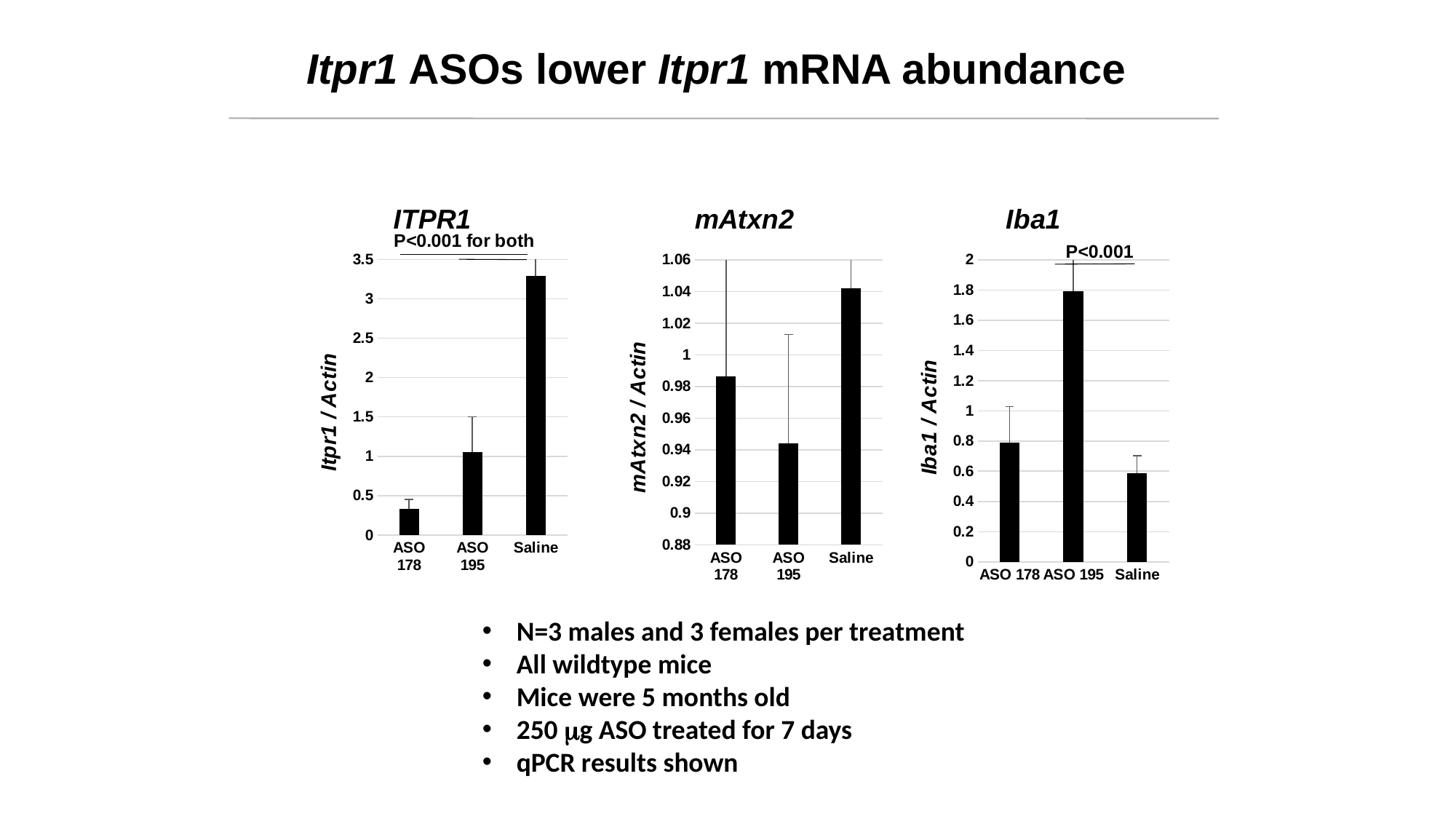
In the mAtxn2 chart, which category has the lowest mAtxn2 / Actin value? ASO 195 In the Iba1 chart, is the value for ASO 195 greater or less than 1.6? greater In the Iba1 chart, which category has the lowest Iba1 / Actin value? Saline How many categories are shown on the x axis of the ITPR1 chart? 3 In the Iba1 chart, which category has the highest Iba1 / Actin value? ASO 195 In the mAtxn2 chart, is the value for Saline greater or less than 1? greater In the ITPR1 chart, which category has the lowest Itpr1 / Actin value? ASO 178 In the mAtxn2 chart, which category has the highest mAtxn2 / Actin value? Saline In the ITPR1 chart, is the value for Saline greater or less than 3? greater In the ITPR1 chart, which category has the highest Itpr1 / Actin value? Saline In the Iba1 chart, which is larger, the value for ASO 178 or the value for Saline? ASO 178